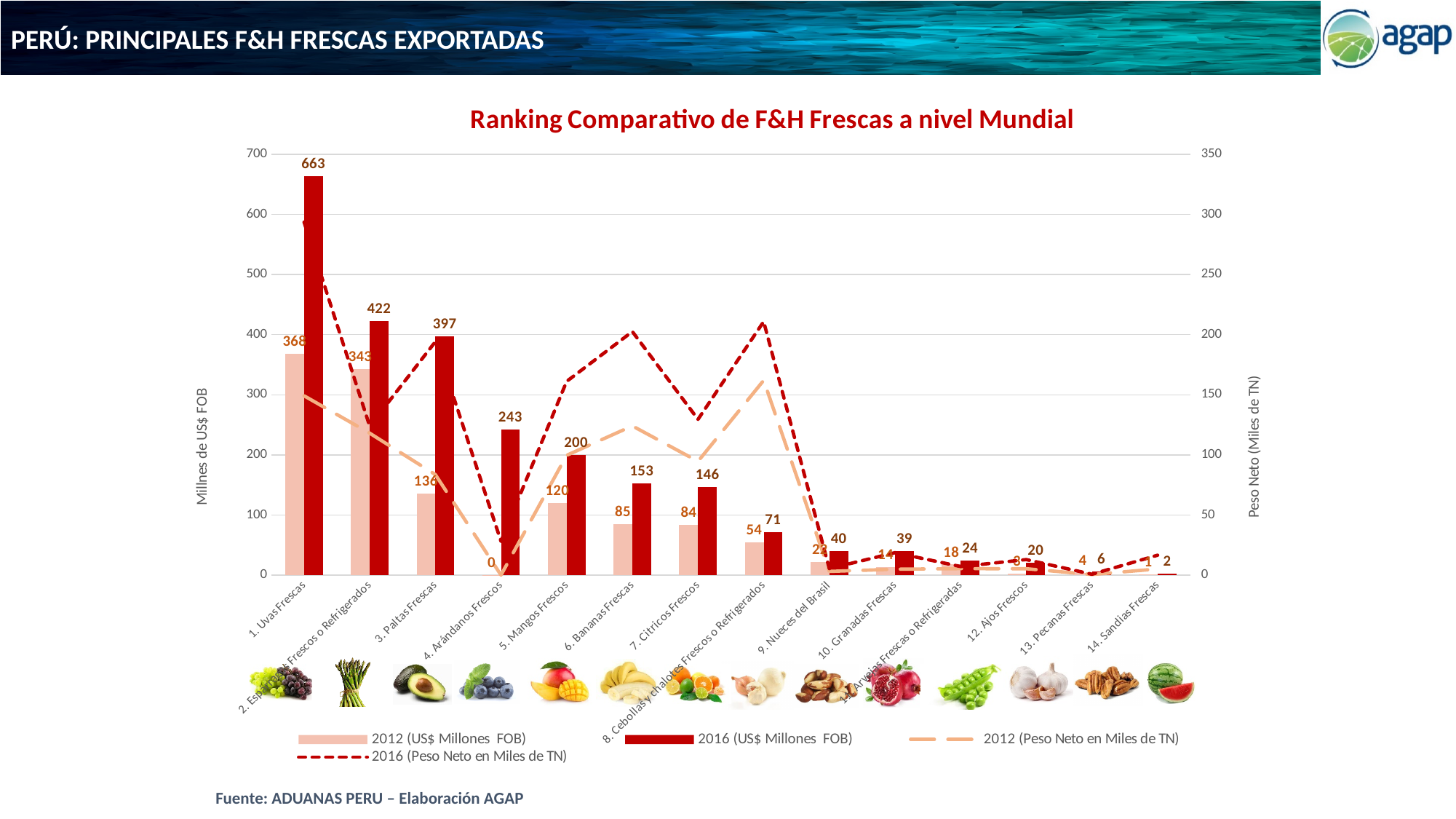
What is the 2012 (US$ Millones FOB) value for 4. Arándanos Frescos? 0 What is the 2012 (US$ Millones FOB) value for 3. Paltas Frescas? 136 What is the difference between the 2016 and 2012 US$ Millones FOB values for 3. Paltas Frescas? 261 Which category has the highest 2016 (US$ Millones FOB) bar? 1. Uvas Frescas What is the title of the chart? Ranking Comparativo de F&H Frescas a nivel Mundial Is the 2016 (Peso Neto en Miles de TN) value for 6. Bananas Frescas greater or less than 150? greater What is the 2016 (US$ Millones FOB) value for 4. Arándanos Frescos? 243 What is the difference between the 2016 and 2012 US$ Millones FOB values for 1. Uvas Frescas? 295 What is the 2016 (US$ Millones FOB) value for 1. Uvas Frescas? 663 How many product categories are shown on the x axis? 14 How many series does the legend list? 4 Which has the larger 2016 (US$ Millones FOB) value: 2. Espárragos Frescos o Refrigerados or 3. Paltas Frescas? 2. Espárragos Frescos o Refrigerados